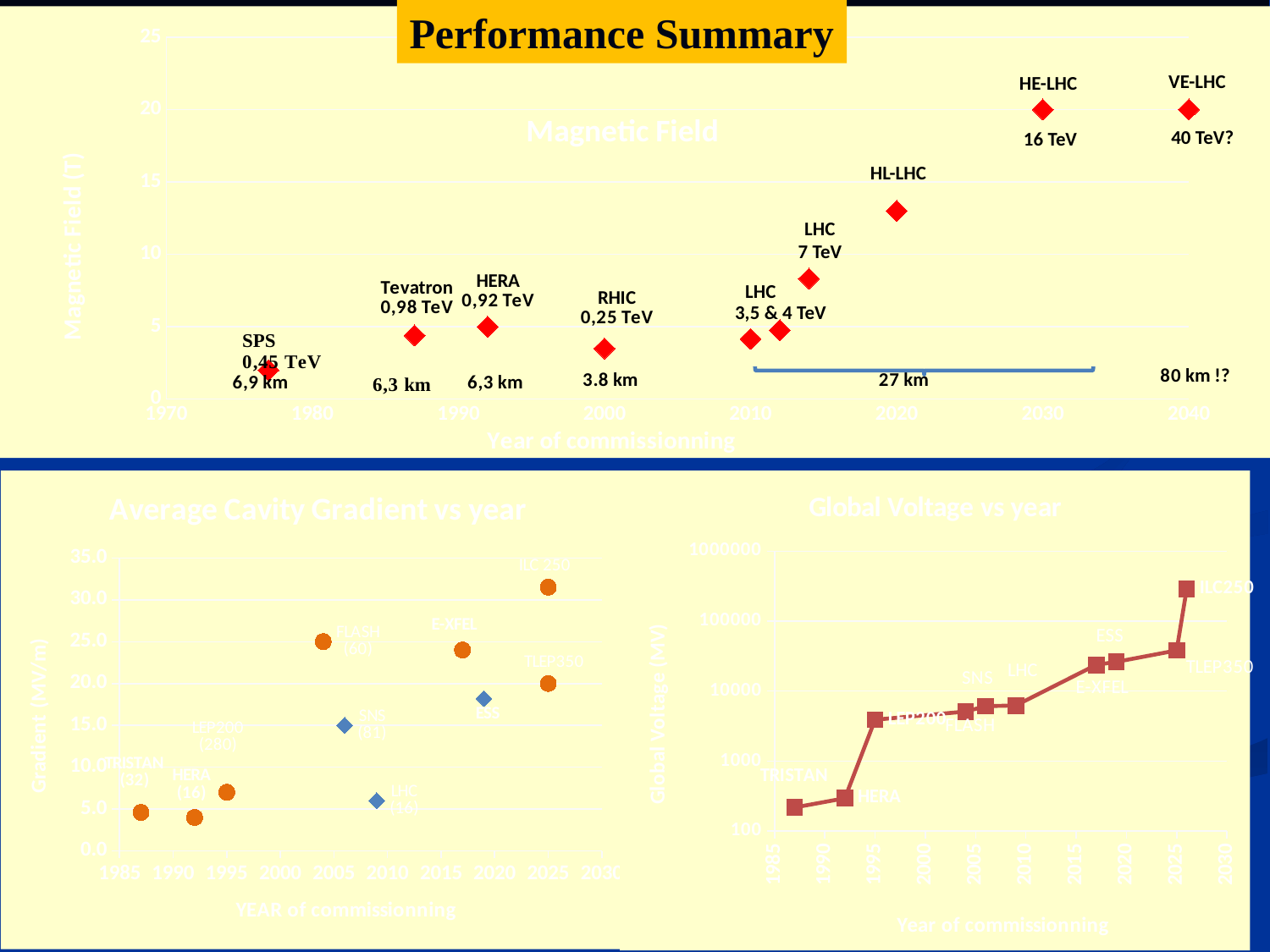
In the bottom-left "Average Cavity Gradient vs year" chart, which project has the highest gradient? ILC 250 In the bottom-left "Average Cavity Gradient vs year" chart, is the gradient for FLASH greater or less than 20.0? greater In the bottom-right "Global Voltage vs year" chart, do the values rise or fall as the year increases? rise In the top "Magnetic Field" chart, which machine has the lowest magnetic field? SPS In the top "Magnetic Field" chart, is the magnetic field for RHIC greater or less than 5? less What kind of chart is the bottom-right "Global Voltage vs year" chart? line chart In the top "Magnetic Field" chart, is the magnetic field for HL-LHC greater or less than 10? greater In the top "Magnetic Field" chart, what energy is labelled for the Tevatron? 0,98 TeV In the bottom-left "Average Cavity Gradient vs year" chart, which has the higher gradient, E-XFEL or ESS? E-XFEL In the top "Magnetic Field" chart, what energy is labelled for HE-LHC? 16 TeV What kind of chart is the top chart titled "Magnetic Field"? scatter chart In the top "Magnetic Field" chart, what circumference is labelled for RHIC? 3.8 km